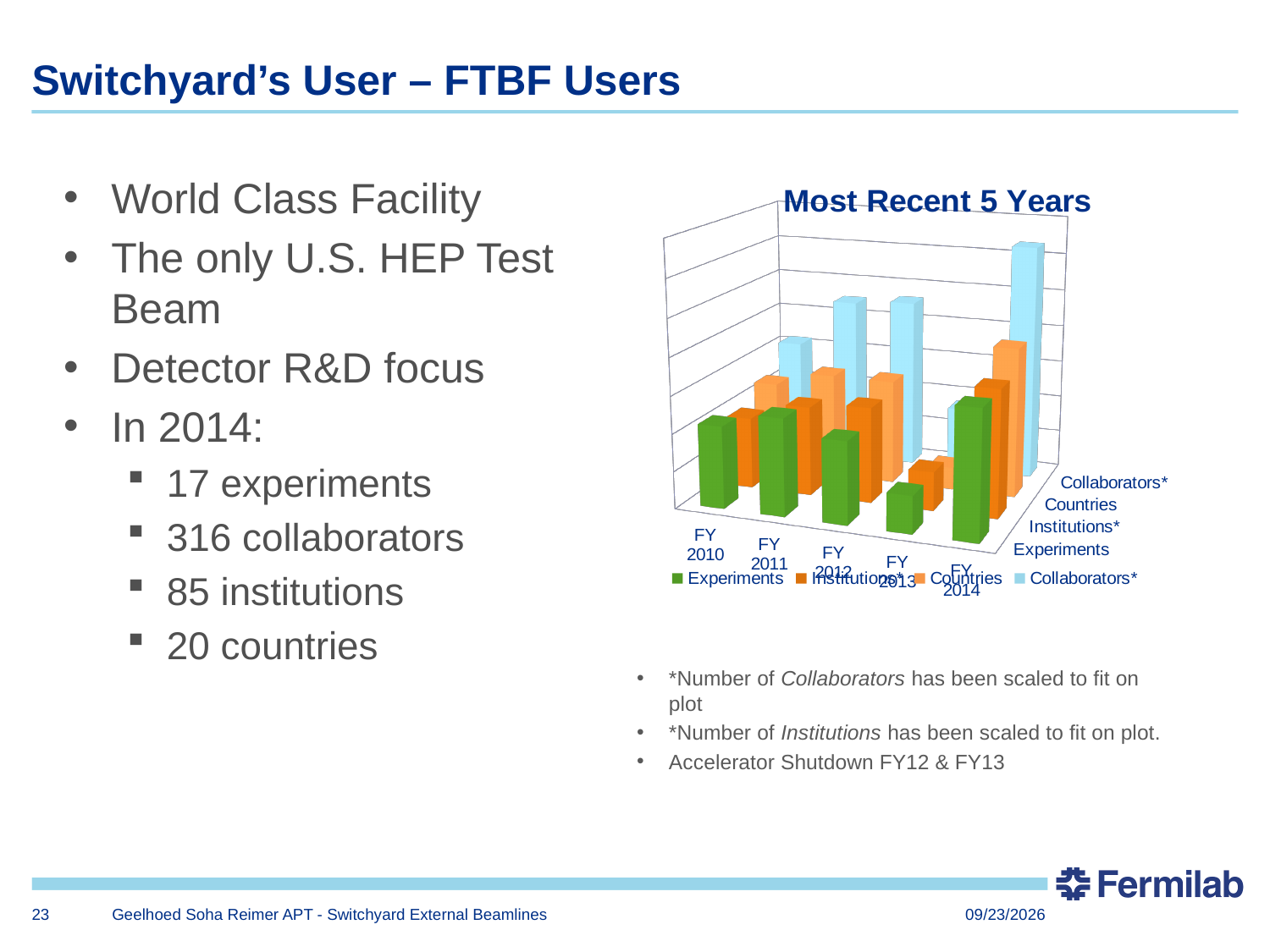
In which fiscal year is the Collaborators* bar the tallest? FY 2014 Which series has the tallest bar in FY 2010? Collaborators* Is the Collaborators* bar taller in FY 2014 or in FY 2010? FY 2014 Which series are listed in the chart's legend? Experiments, Institutions*, Countries, Collaborators* In which fiscal year is the Experiments bar the shortest? FY 2013 Which series has the tallest bar in FY 2014? Collaborators* How many series does the chart's legend list? 4 Is the Experiments bar taller in FY 2013 or in FY 2014? FY 2014 How many fiscal years are shown on the chart's x axis? 5 What kind of chart is shown on the slide? bar chart What is the title of the chart? Most Recent 5 Years In which fiscal year is the Collaborators* bar the shortest? FY 2013